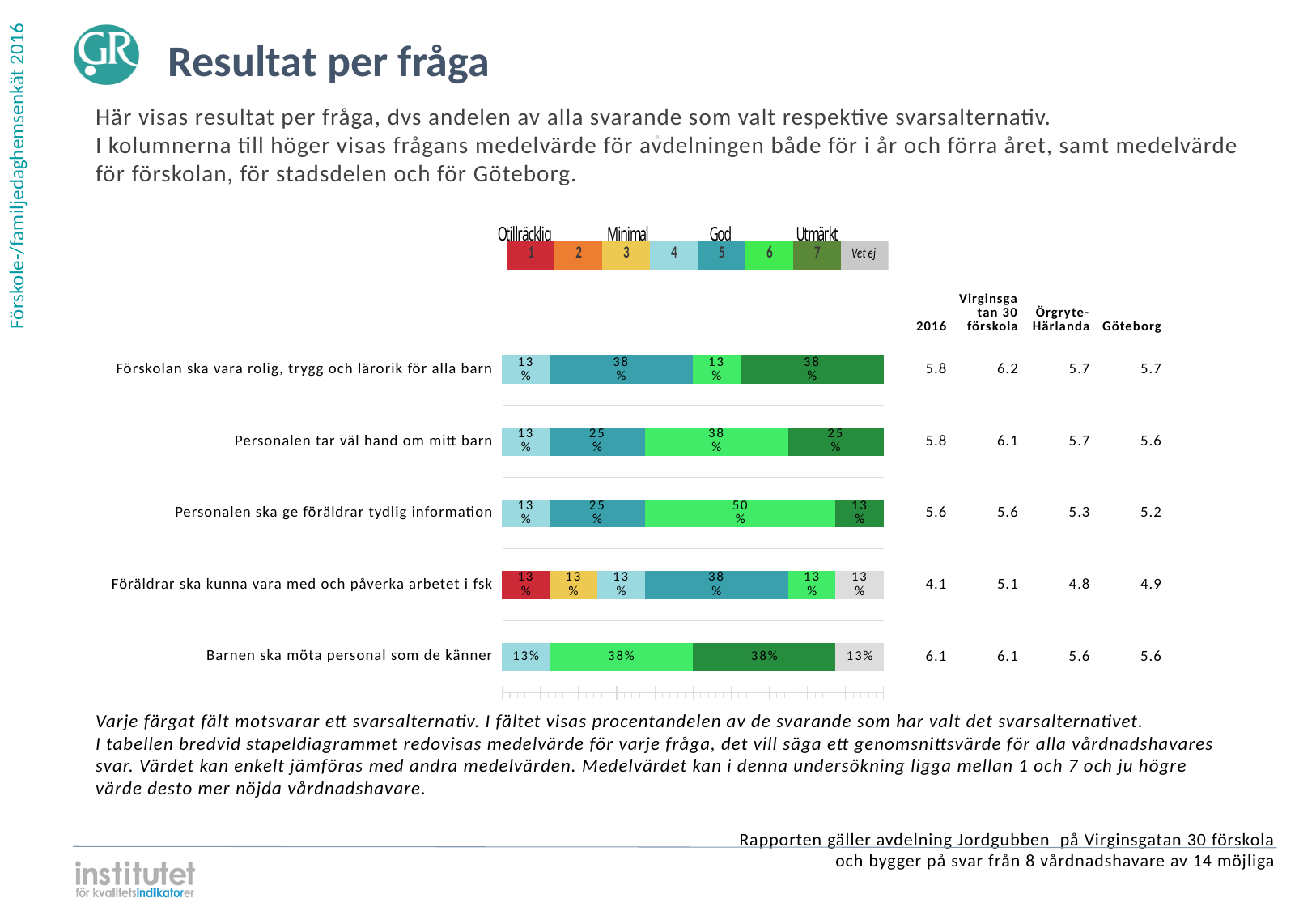
What is the difference between the share for alternative 6 and the share for alternative 7 in 'Personalen ska ge föräldrar tydlig information'? 37 percentage points What kind of chart is shown on the slide? Stacked bar chart What percentage of respondents chose alternative 6 for 'Personalen ska ge föräldrar tydlig information'? 50% How many answer alternatives does the legend above the chart list? 8 Which answer alternative has the largest share for 'Personalen tar väl hand om mitt barn'? 6 How many questions (categories) are plotted as bars in the chart? 5 What is the 2016 mean value shown for 'Föräldrar ska kunna vara med och påverka arbetet i fsk'? 4.1 Which question is the only one with a red (alternative 1) segment in its bar? Föräldrar ska kunna vara med och påverka arbetet i fsk For 'Personalen tar väl hand om mitt barn', which is larger: the share for alternative 5 or the share for alternative 6? Alternative 6 What percentage of respondents chose alternative 7 (Utmärkt) for 'Förskolan ska vara rolig, trygg och lärorik för alla barn'? 38% Which answer alternative has the largest share for 'Föräldrar ska kunna vara med och påverka arbetet i fsk'? 5 What percentage of respondents answered 'Vet ej' for 'Barnen ska möta personal som de känner'? 13%